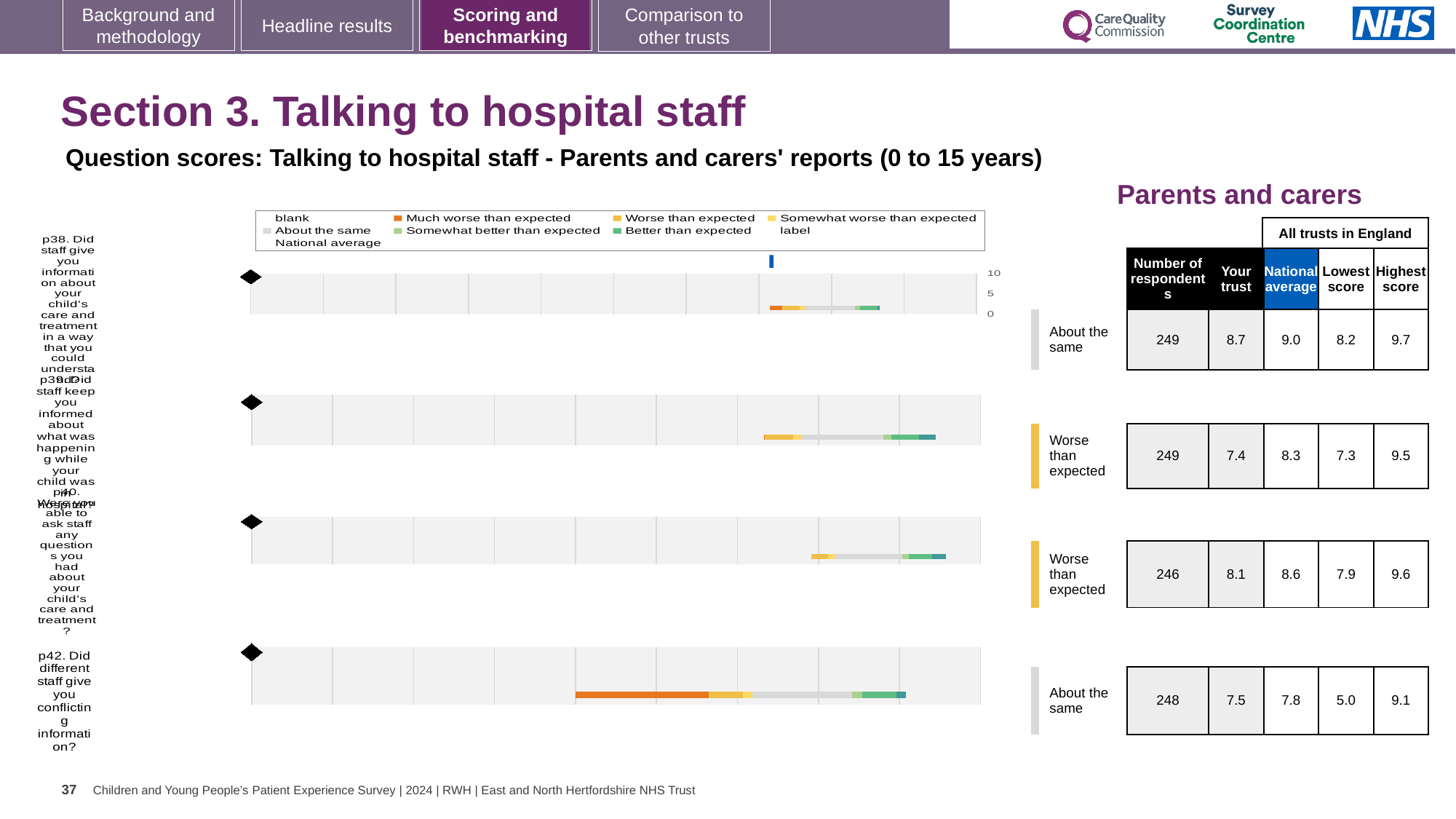
What benchmark category is shown for p40 (able to ask staff questions)? Worse than expected For p39, which is larger: the 'Your trust' score or the national average? National average According to the table beside the chart, what is the 'Your trust' score for p38 (information about your child's care and treatment)? 8.7 According to the table beside the chart, how many respondents answered p40 (able to ask staff questions)? 246 Which question has the lowest 'Lowest score' value in the table beside the chart? p42 According to the table beside the chart, what is the national average for p39 (staff keeping you informed)? 8.3 What is the difference between the national average and the 'Your trust' score for p38? 0.3 What type of chart is used to show the question scores on this slide? bar chart In the chart legend, what colour represents 'Much worse than expected'? orange How many survey questions (bars) are shown in the chart? 4 According to the table beside the chart, what is the lowest score across all trusts in England for p42 (conflicting information)? 5.0 Which question has the highest 'Your trust' score in the table beside the chart? p38